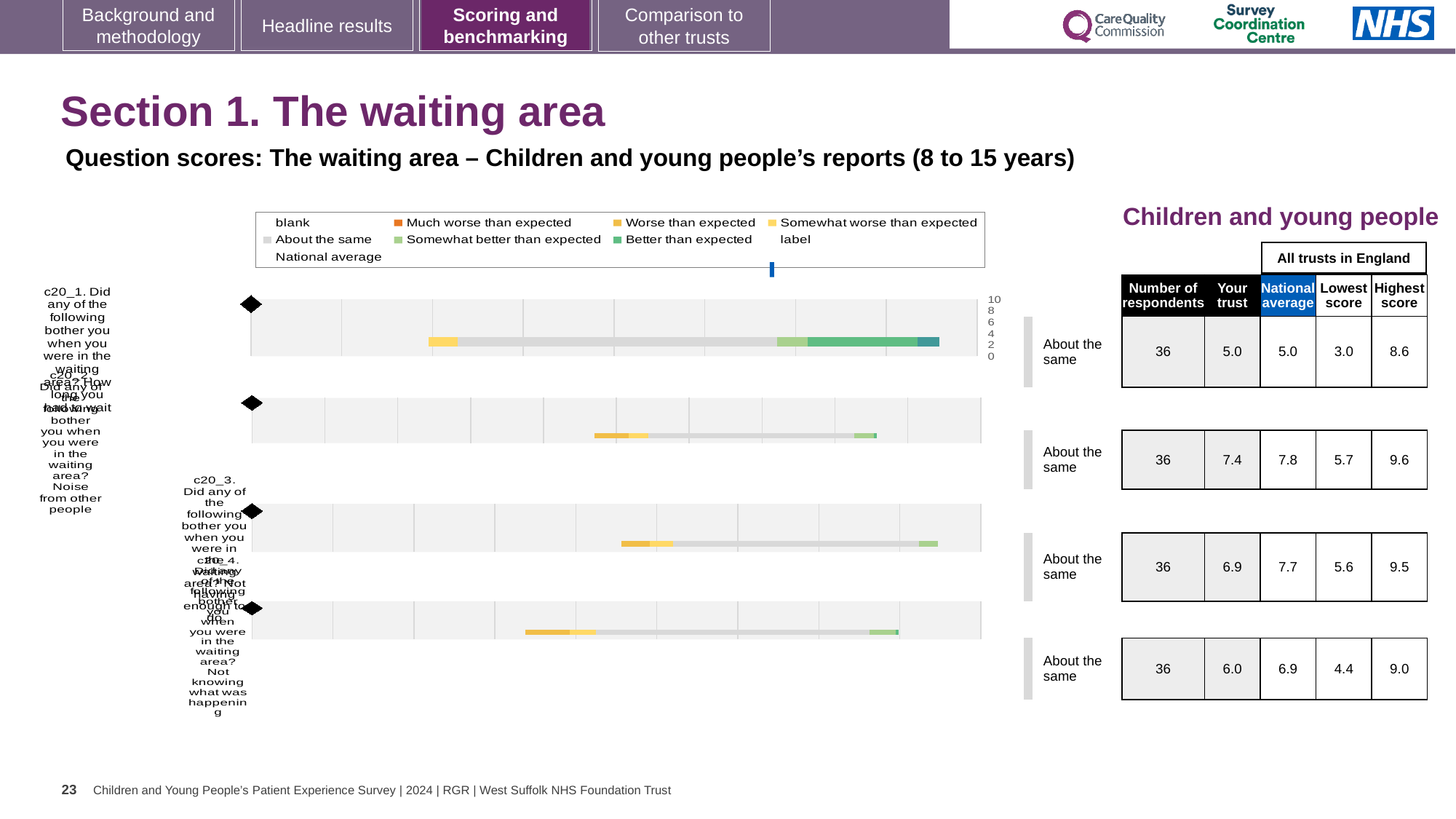
How many question rows (c20_1 to c20_4) are plotted on the slide? 4 For c20_4, what is the difference between the highest score and the lowest score across all trusts in England? 4.6 What kind of chart is used to show the question scores on this slide? bar chart Which question row has the lowest 'Your trust' score? c20_1 Which question row has the highest 'Your trust' score? c20_2 What benchmark category is shown next to each of the four question rows? About the same What is the highest score across all trusts in England for the fourth row, c20_4? 9.0 What is the 'Your trust' score for the first row, c20_1? 5.0 What is the national average for the second row, c20_2? 7.8 For c20_2, what is the difference between the national average and the 'Your trust' score? 0.4 How many respondents are shown for the third row, c20_3? 36 For c20_3, which is larger: the 'Your trust' score or the national average? National average